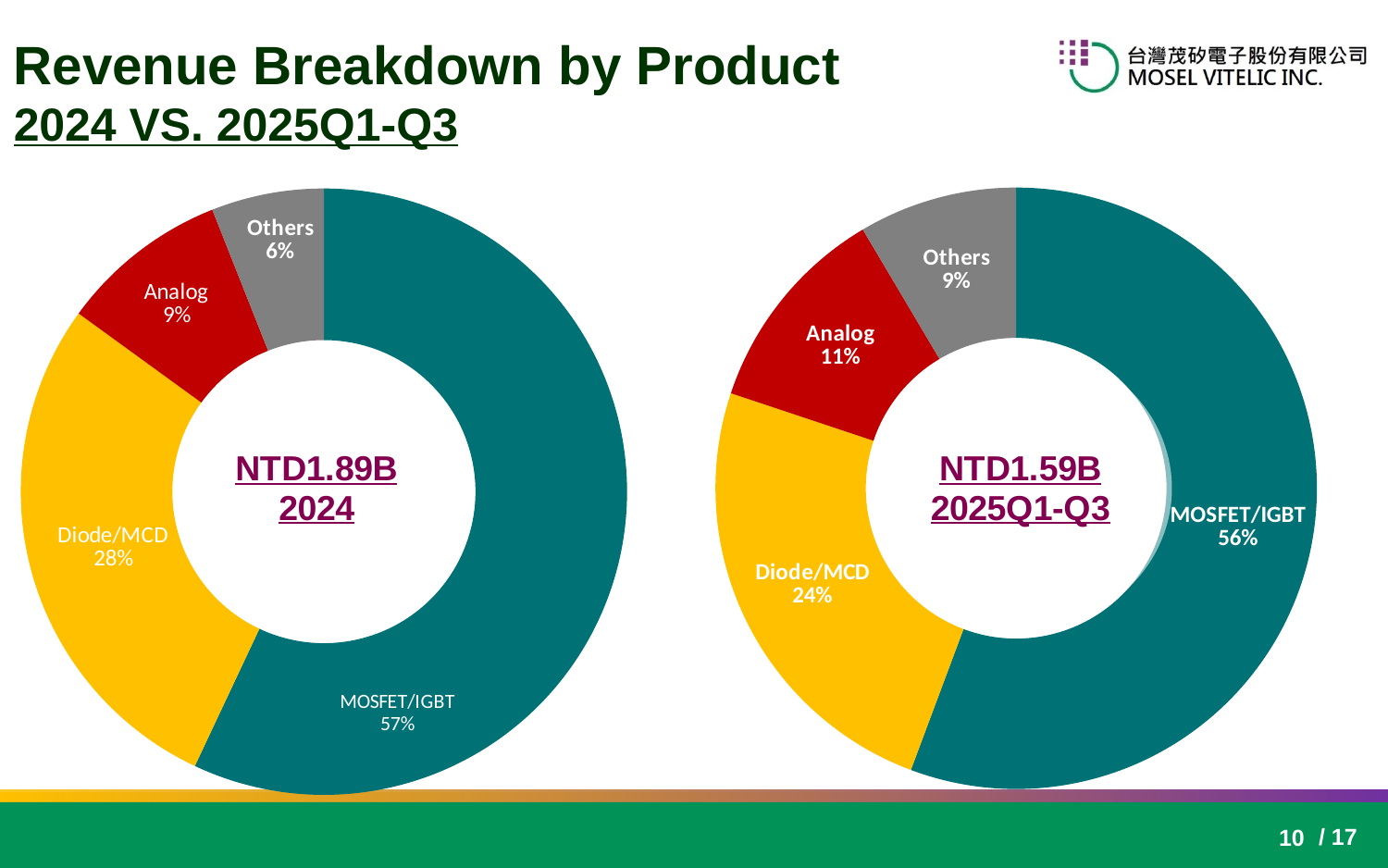
In the 2024 chart, which product category has the smallest share? Others What type of chart is used on this slide? Pie chart (donut) What is the difference between the Diode/MCD share in 2024 and in 2025Q1-Q3? 4 percentage points What total revenue is shown in the centre of the 2025Q1-Q3 chart? NTD1.59B In the 2025Q1-Q3 chart, what is the share for Analog? 11% How many product categories are shown in the 2024 chart? 4 In the 2024 chart, which product category has the largest share? MOSFET/IGBT Is the Others share larger in the 2024 chart or the 2025Q1-Q3 chart? 2025Q1-Q3 In the 2025Q1-Q3 chart, which product category has the smallest share? Others In the 2024 chart, what share of revenue does MOSFET/IGBT account for? 57% In the 2025Q1-Q3 chart, what share of revenue does Diode/MCD account for? 24% What total revenue is shown in the centre of the 2024 chart? NTD1.89B